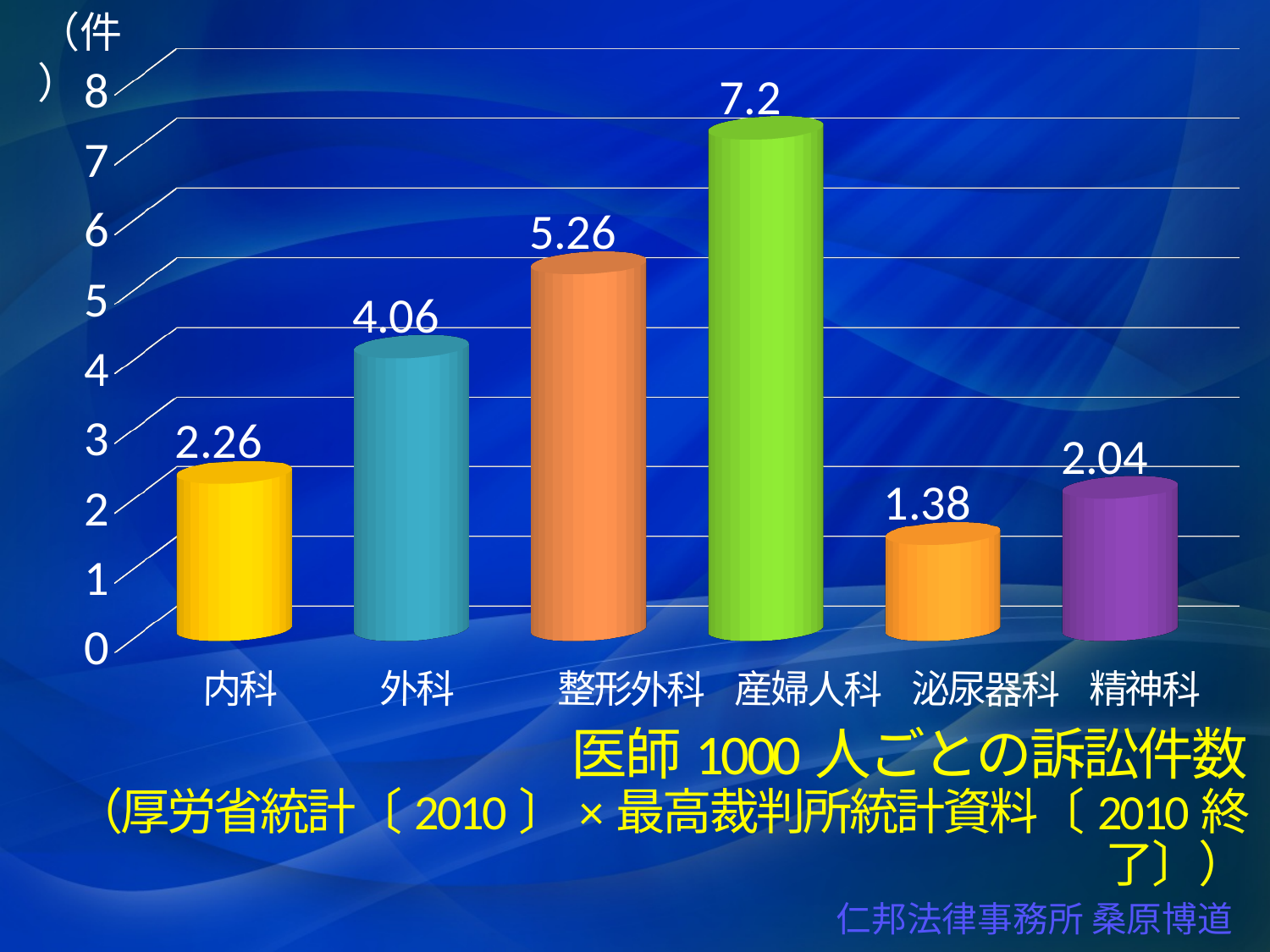
What unit is shown at the top of the vertical axis? 件 What is the value for 産婦人科? 7.2 What is the difference between the values for 産婦人科 and 泌尿器科? 5.82 Which is larger, the value for 内科 or the value for 精神科? 内科 Is the value for 外科 greater or less than 4? greater Which category has the lowest value? 泌尿器科 Which category has the highest value? 産婦人科 What is the value for 内科? 2.26 How many categories are shown on the x axis? 6 What is the difference between the values for 整形外科 and 外科? 1.2 What kind of chart is shown on the slide? bar chart What is the value for 泌尿器科? 1.38